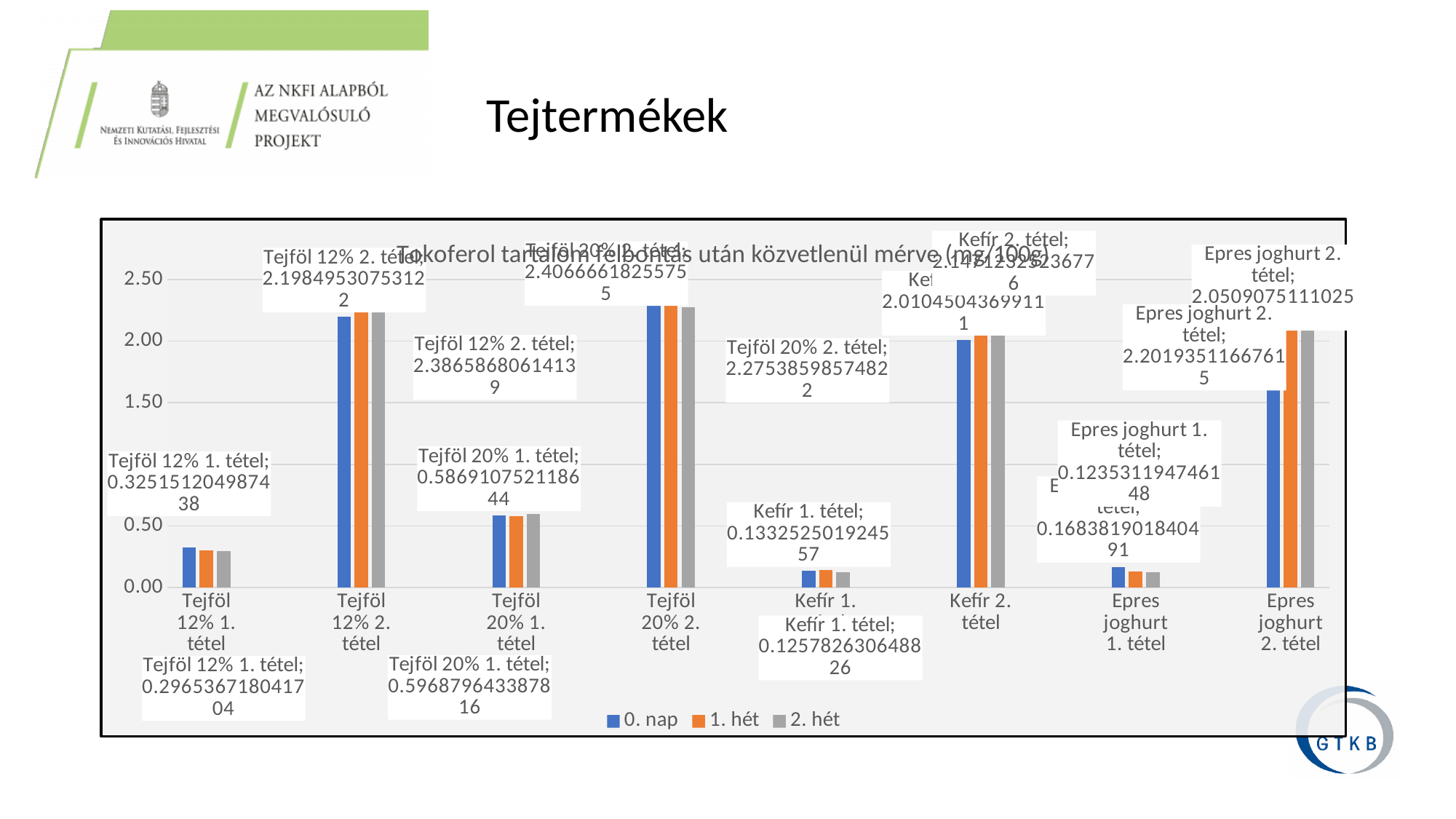
How many series does the legend list? 3 Is the 0. nap value for Tejföl 20% 1. tétel greater or less than 1.00? less Which category has the highest bars in the chart? Tejföl 20% 2. tétel What kind of chart is shown on the slide? bar chart Is the 0. nap value for Tejföl 12% 2. tétel greater or less than 2.00? greater Which has the larger 0. nap value: Kefír 1. tétel or Kefír 2. tétel? Kefír 2. tétel Is the 0. nap value for Epres joghurt 2. tétel greater or less than 2.00? greater What are the series names listed in the legend? 0. nap, 1. hét, 2. hét How many product categories are shown on the x axis? 8 For Epres joghurt 2. tétel, which is larger: the 0. nap value or the 1. hét value? 1. hét